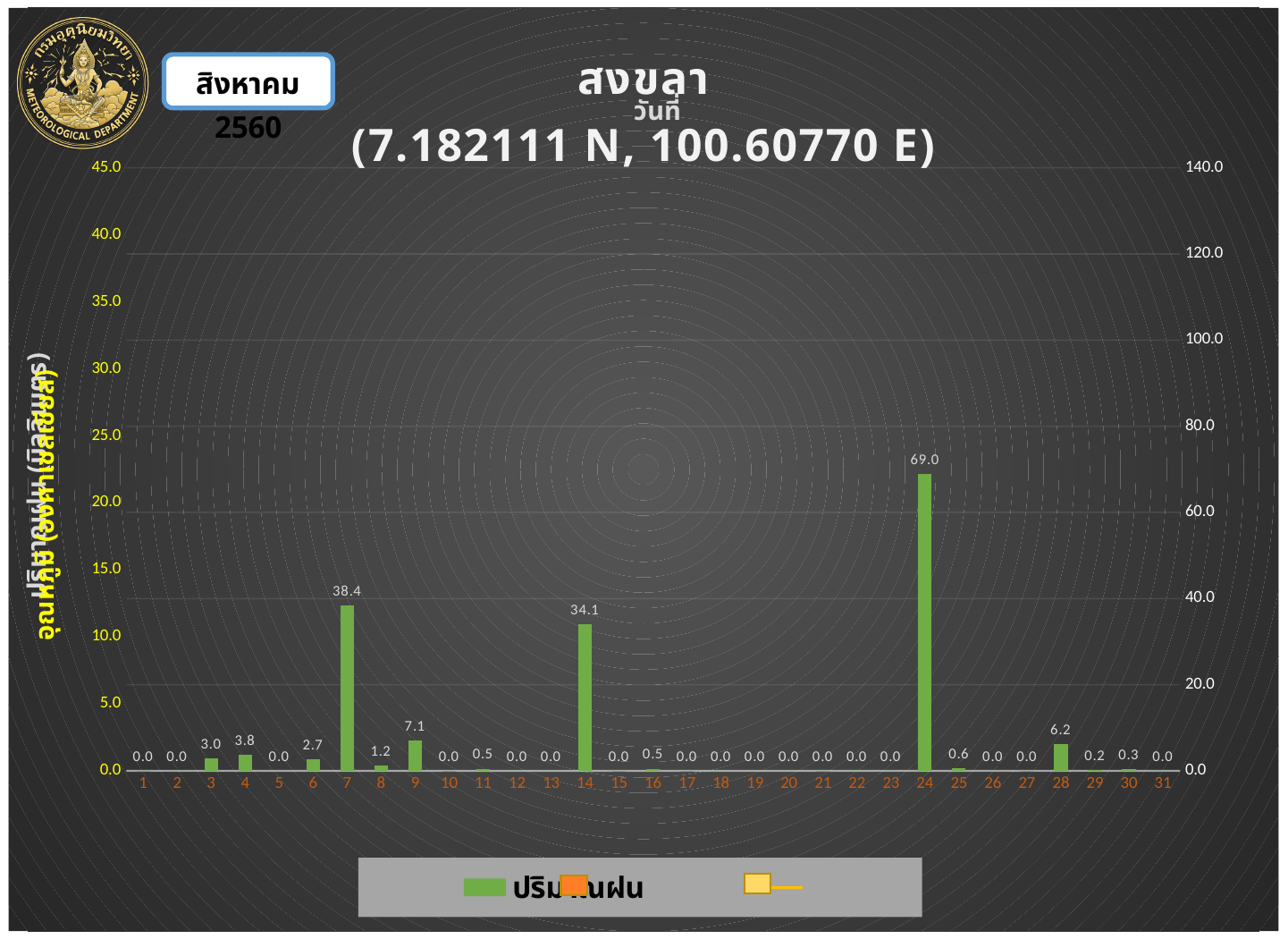
What colour are the rainfall (ปริมาณฝน) bars in the chart? green What is the rainfall value shown for day 14? 34.1 How many days are shown on the x axis of the chart? 31 Which day has the highest rainfall value? 24 Which has a larger rainfall value, day 3 or day 4? day 4 What is the difference between the rainfall values for day 24 and day 7? 30.6 Which has a larger rainfall value, day 9 or day 28? day 9 What is the rainfall value shown for day 24? 69.0 What kind of chart is used to show the rainfall data? bar chart What is the difference between the rainfall values for day 7 and day 14? 4.3 What is the rainfall value shown for day 7? 38.4 What is the rainfall value shown for day 28? 6.2